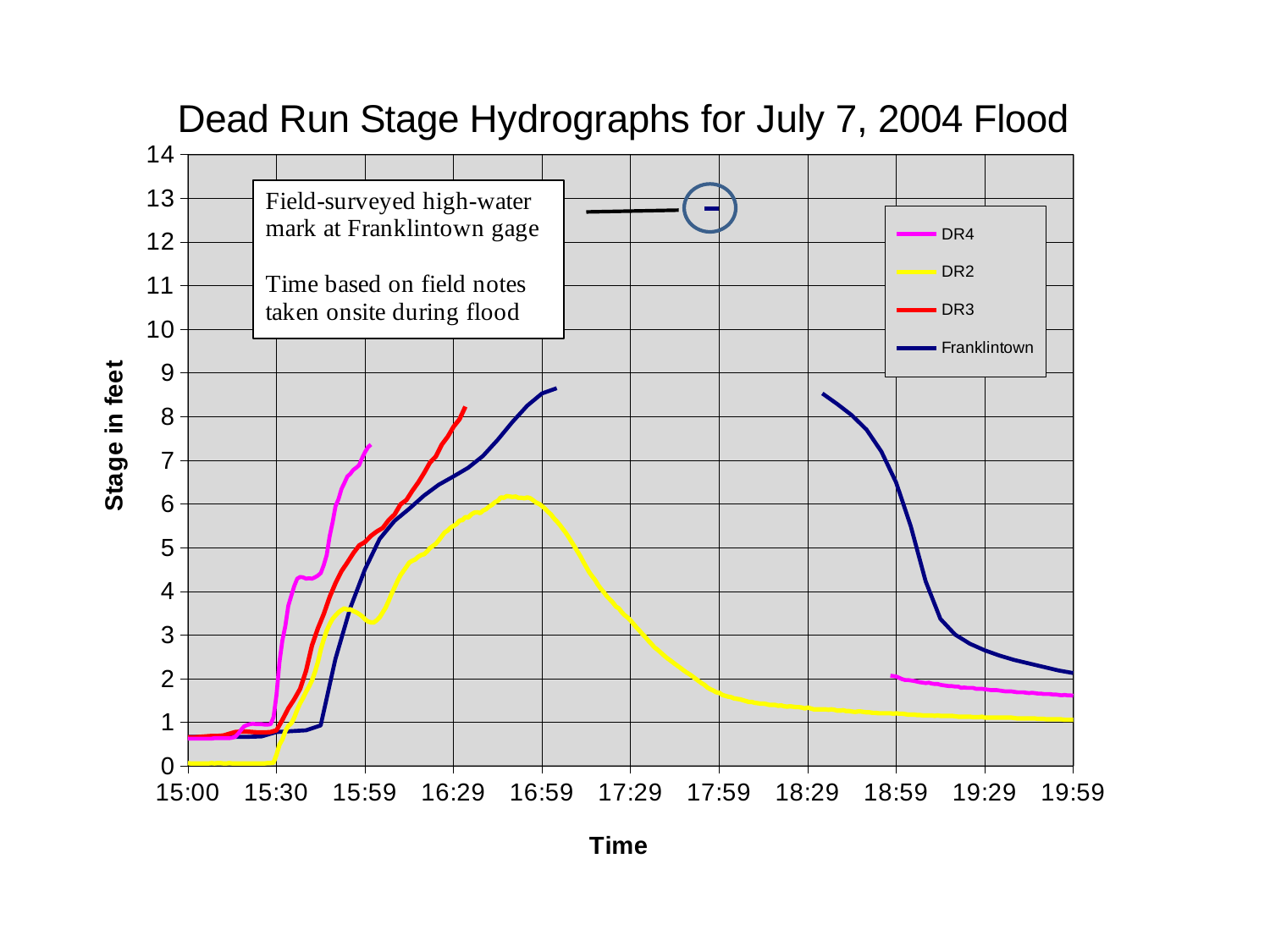
How many series does the legend list? 4 At 16:29, which series has the higher stage, DR3 or DR2? DR3 What kind of chart is shown on the slide? Line chart What is the title of the chart? Dead Run Stage Hydrographs for July 7, 2004 Flood Does the DR2 series rise or fall between 16:59 and 17:59? Fall Is the value of the DR2 series at 19:59 greater or less than 2? less Is the peak value of the Franklintown series greater or less than 8? greater Is the peak value of the DR2 series greater or less than 5? greater What is the label on the vertical axis? Stage in feet At 19:59, which series has the higher stage, Franklintown or DR2? Franklintown Which series reaches the lowest peak stage? DR2